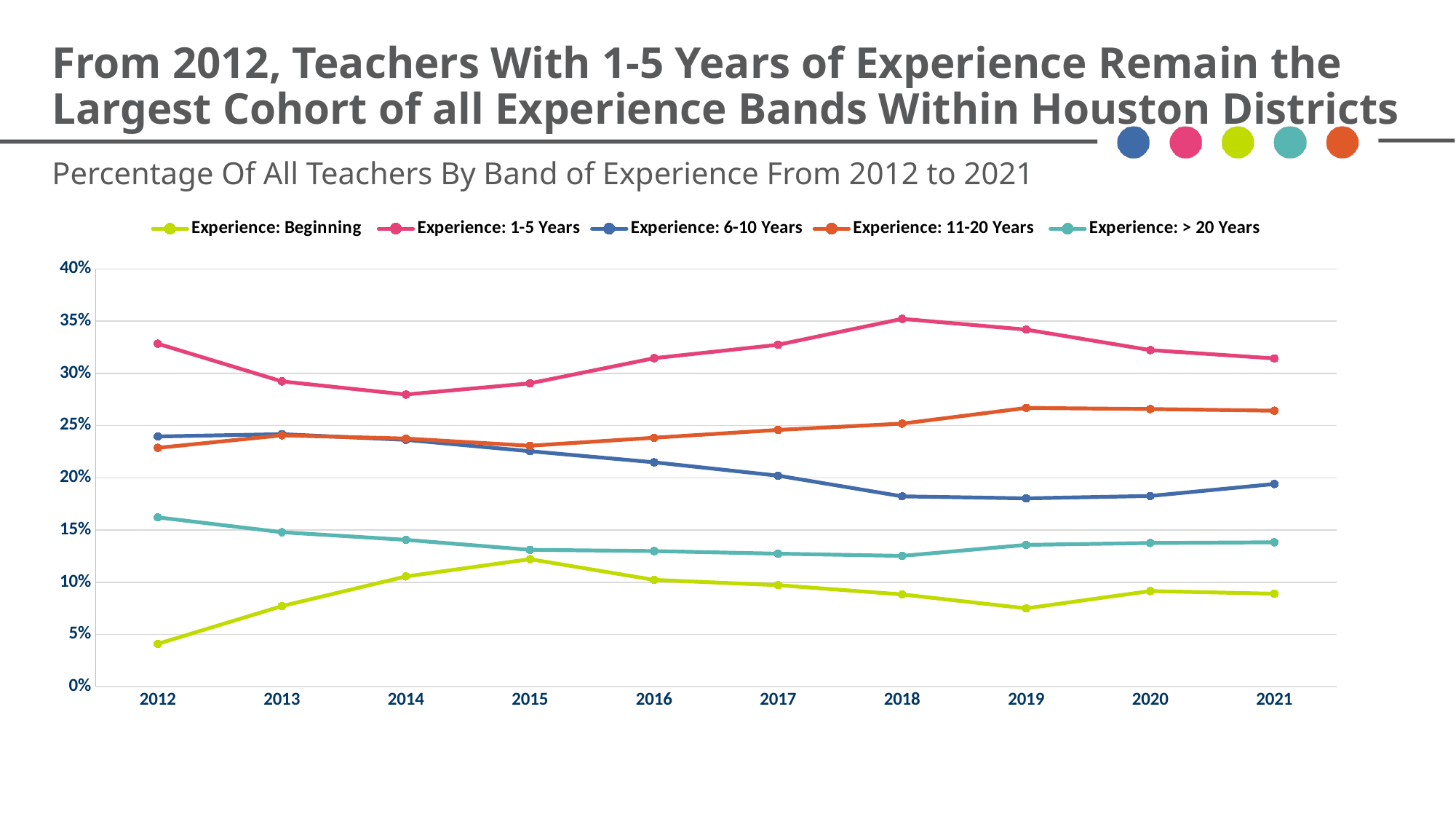
In which year does the Experience: 1-5 Years line reach its highest point? 2018 Is the value for Experience: 1-5 Years in 2014 greater or less than 30%? less What kind of chart is shown on the slide? Line chart Is the value for Experience: Beginning in 2012 greater or less than 5%? less In which year does the Experience: Beginning line reach its highest point? 2015 In 2021, which is larger: Experience: 6-10 Years or Experience: 11-20 Years? Experience: 11-20 Years How many years are plotted along the x axis? 10 How many series does the legend list? 5 Which experience band has the lowest percentage in 2012? Experience: Beginning Is the value for Experience: > 20 Years in 2012 greater or less than 15%? greater Does the Experience: 6-10 Years line rise or fall from 2013 to 2019? Fall Which experience band has the highest percentage in 2018? Experience: 1-5 Years